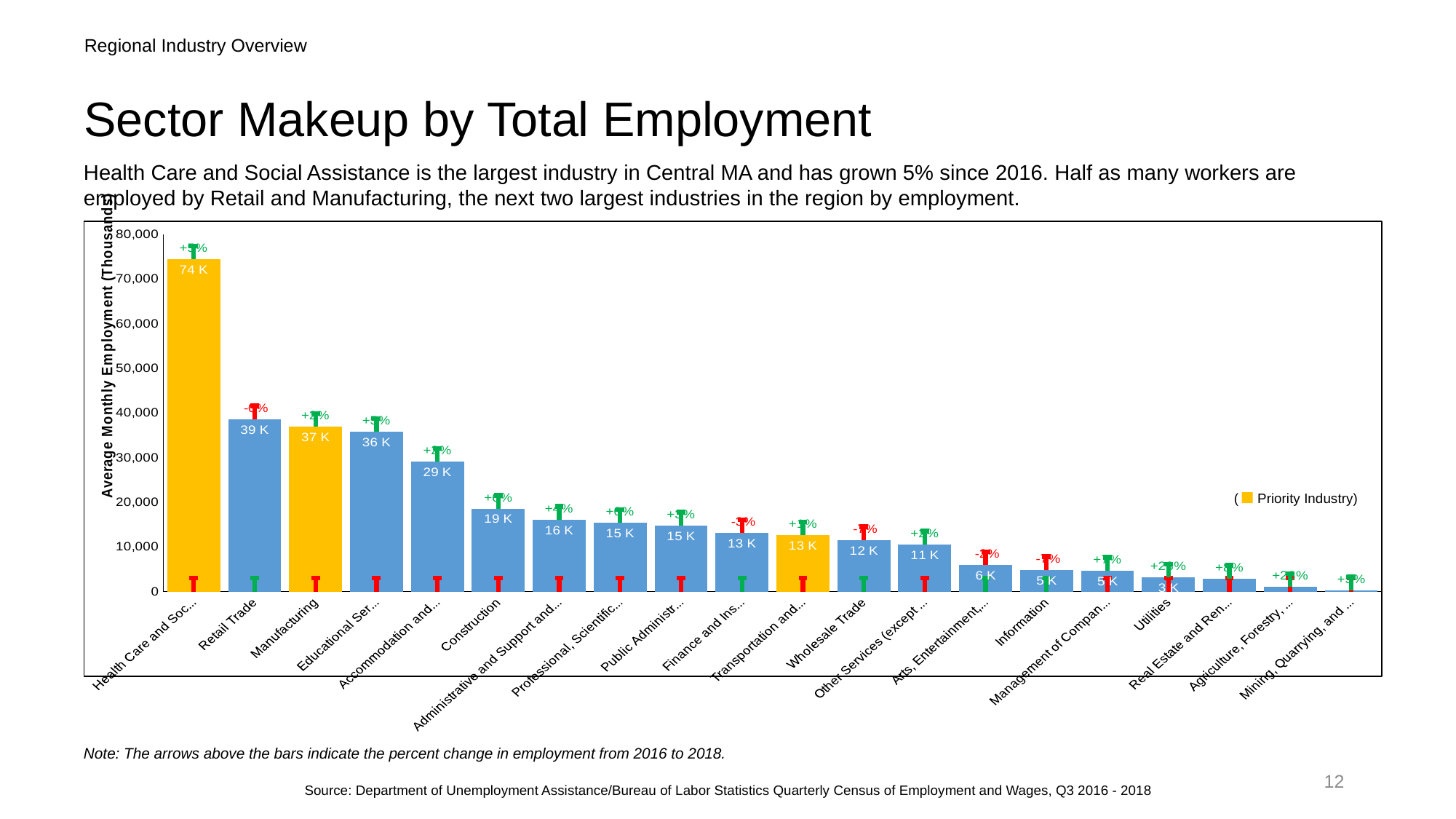
What is the difference between the Construction bar and the Wholesale Trade bar? 7 K Which is larger, the value for Manufacturing or the value for Educational Services? Manufacturing How many industry categories are plotted on the x axis? 20 Which industry has the highest average monthly employment? Health Care and Social Assistance What value is labelled on the Construction bar? 19 K Do the bar values rise or fall moving from left to right along the x axis? fall What kind of chart is shown on the slide? bar chart What is the difference between the Health Care and Social Assistance bar and the Retail Trade bar? 36 K Is the value for Accommodation and Food Services greater or less than 30,000? less What value is labelled on the Wholesale Trade bar? 12 K What is the average monthly employment value shown for Retail Trade? 39 K Which industry has the lowest average monthly employment? Mining, Quarrying, and ...